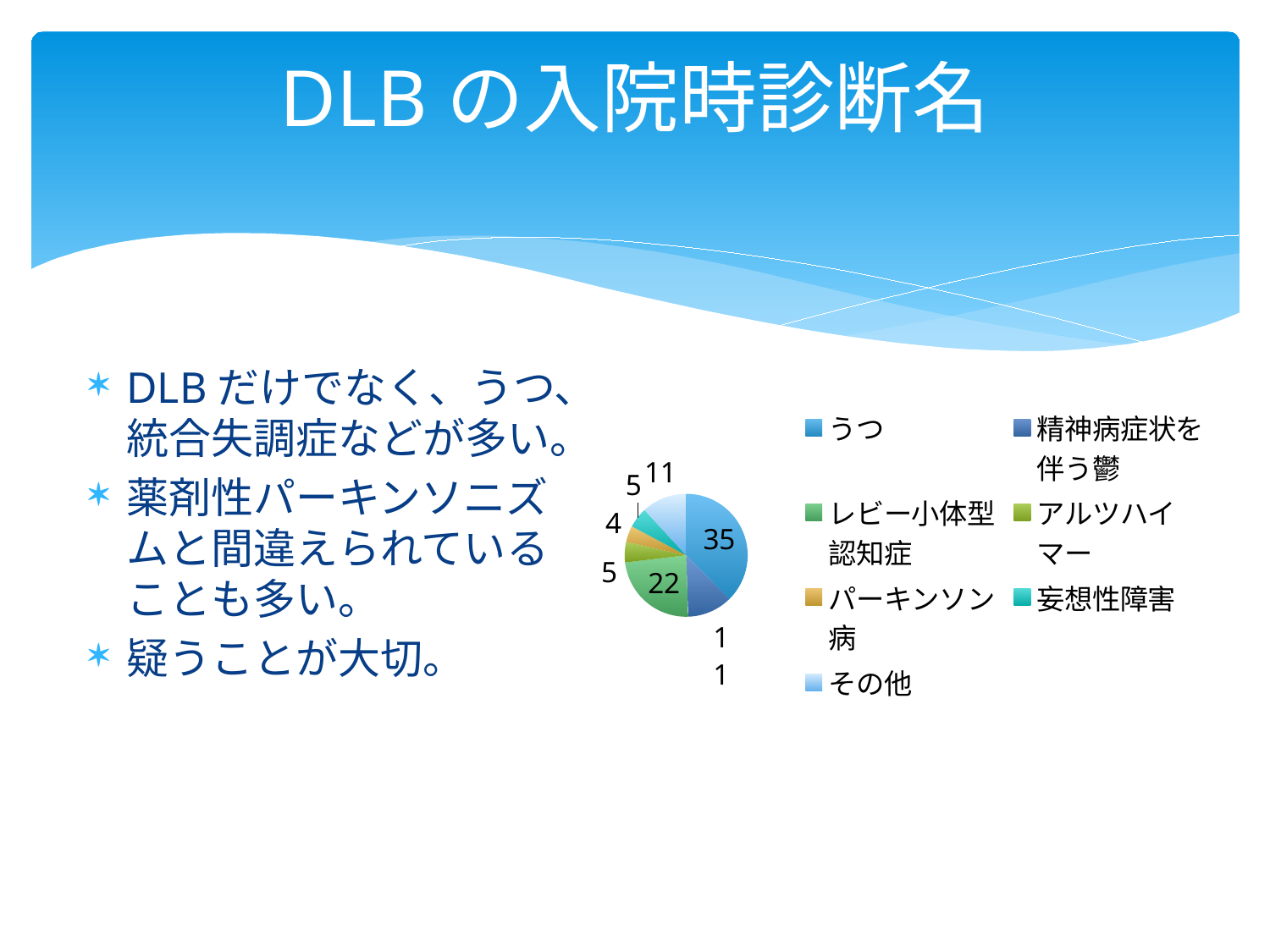
What is the value for アルツハイマー in the pie chart? 5 What is the value for レビー小体型認知症 in the pie chart? 22 What is the value for パーキンソン病 in the pie chart? 4 What colour is the うつ slice in the pie chart? blue Which is larger, the value for レビー小体型認知症 or the value for その他? レビー小体型認知症 What is the difference between the values for うつ and レビー小体型認知症? 13 What kind of chart is shown on the slide? pie chart What is the value for その他 in the pie chart? 11 How many categories does the pie chart's legend list? 7 What is the value for うつ in the pie chart? 35 What is the title of the slide containing the pie chart? DLBの入院時診断名 Which category has the largest slice in the pie chart? うつ